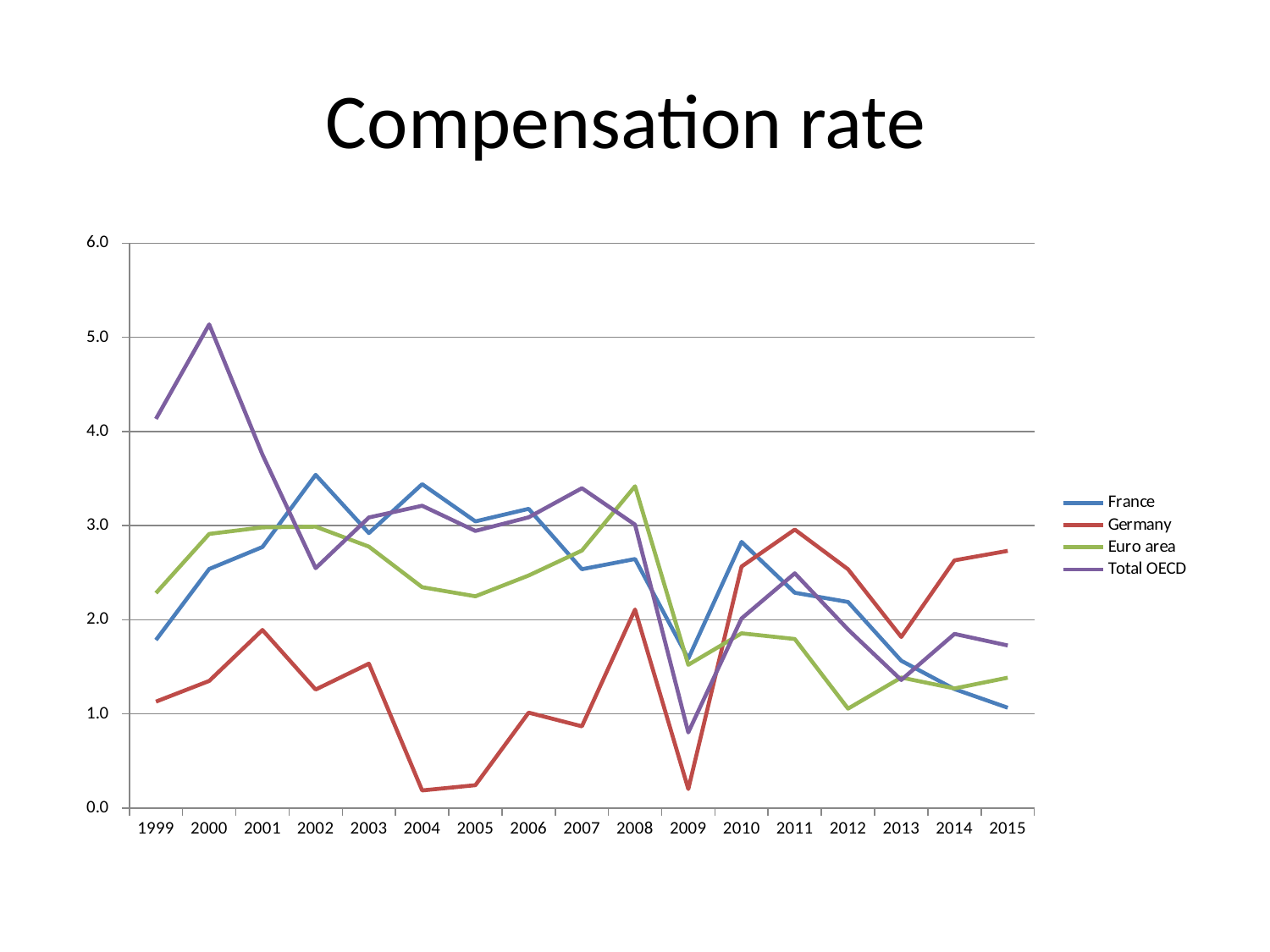
Is the value for Total OECD in 2000 greater or less than 4.0? greater What is the title of the chart? Compensation rate Is the value for Euro area in 2008 greater or less than 3.0? greater What kind of chart is shown on the slide? line chart Which is larger in 2015, the value for Germany or the value for France? Germany In which year does the Total OECD series reach its highest value? 2000 How many series does the legend list? 4 Which series has the highest value in 2000? Total OECD How many years are shown on the x axis? 17 Is the value for Germany in 2004 greater or less than 1.0? less Which series has the highest value in 2015? Germany Which series has the lowest value in 2004? Germany